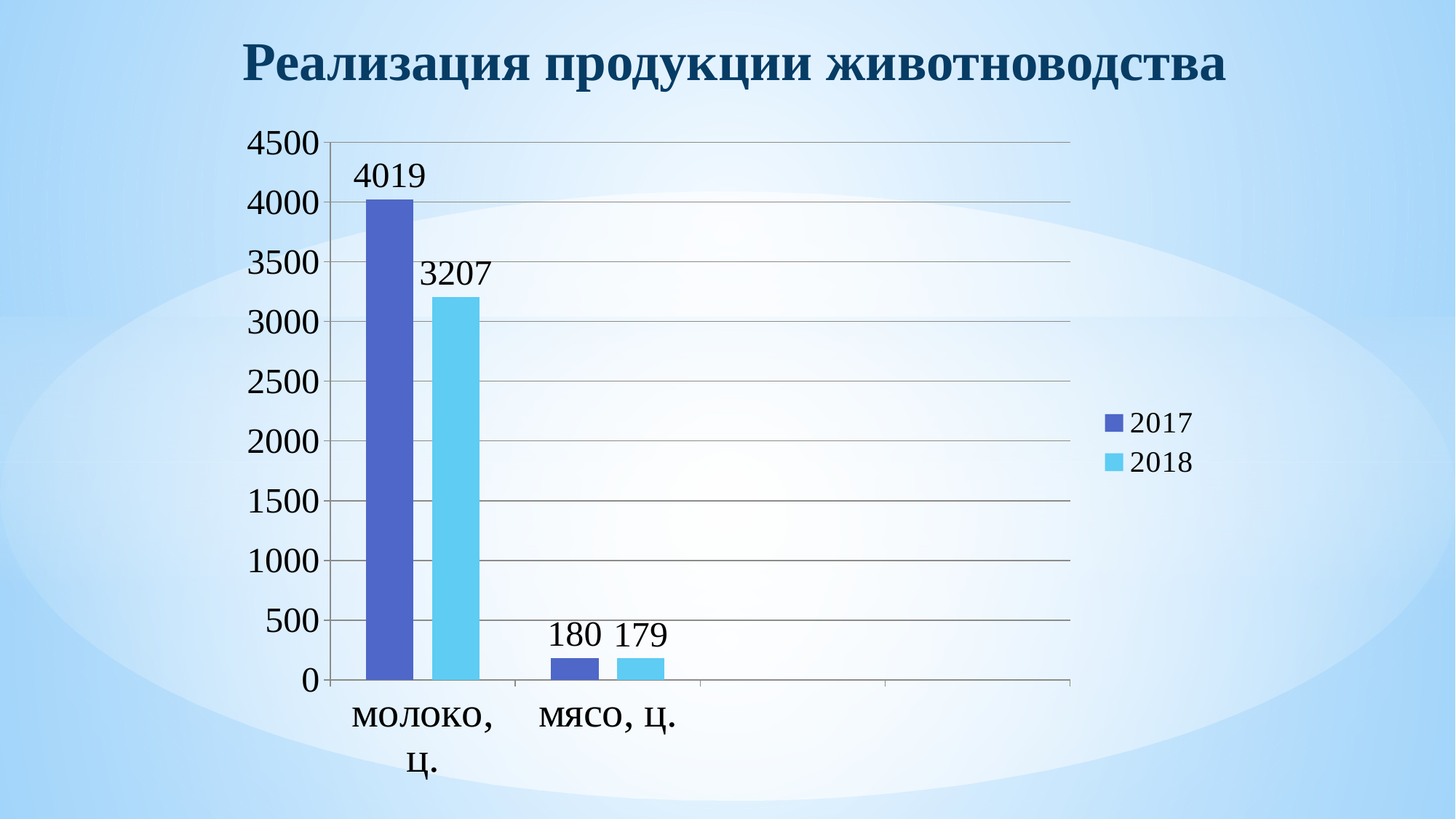
What is the value for молоко, ц. in 2018? 3207 What kind of chart is shown on the slide? bar chart What is the value for мясо, ц. in 2018? 179 Which category has the highest value in 2017? молоко, ц. How many series does the legend list? 2 Which is larger for молоко, ц.: the 2017 value or the 2018 value? 2017 How many categories are shown on the x axis? 2 Which category has the lowest value in 2018? мясо, ц. What is the title of the slide? Реализация продукции животноводства What is the difference between the 2017 and 2018 values for молоко, ц.? 812 What is the value for мясо, ц. in 2017? 180 What is the value for молоко, ц. in 2017? 4019